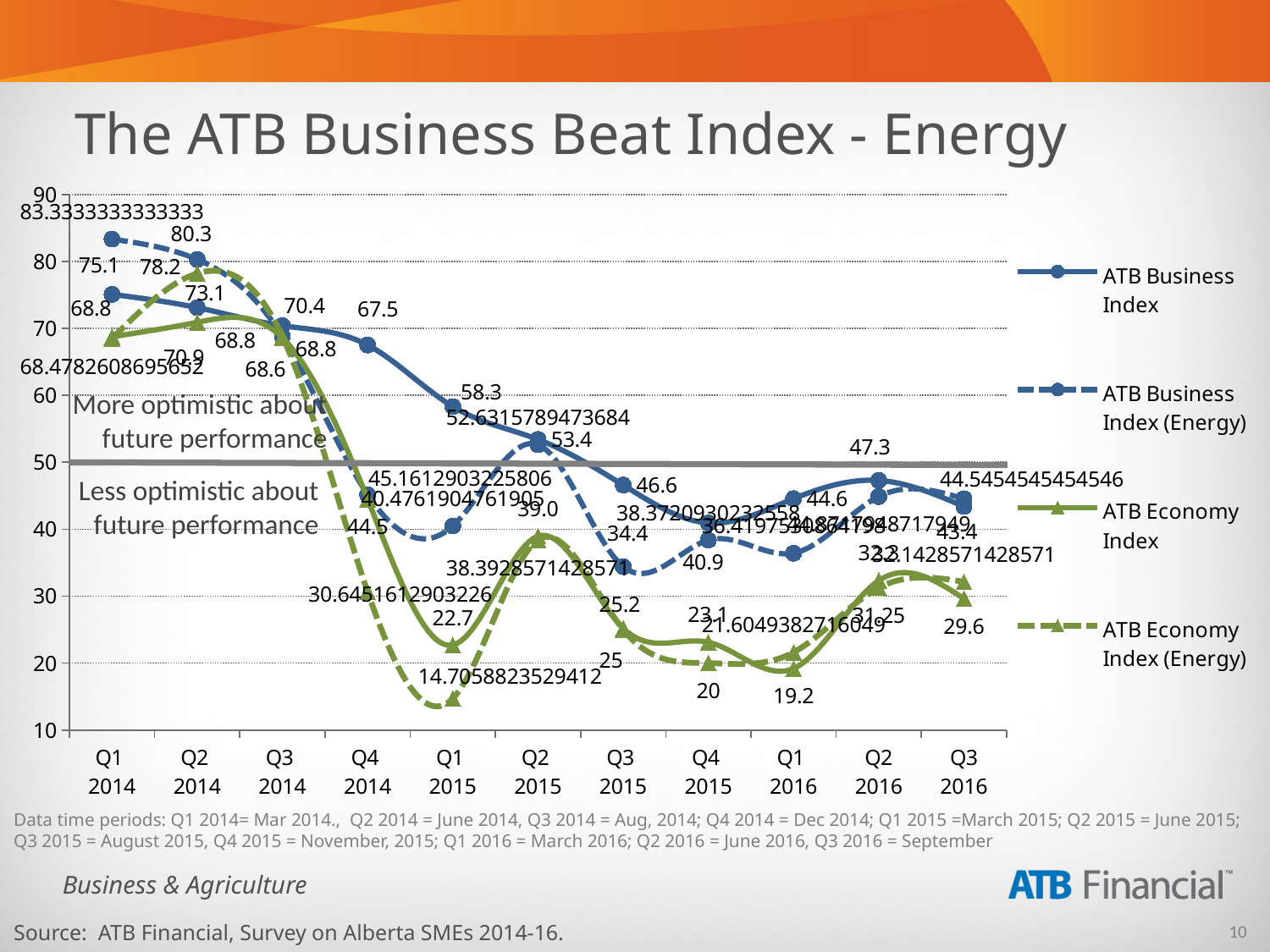
What kind of chart is shown on the slide? line chart In which quarter does the ATB Business Index reach its lowest value? Q4 2015 Is the ATB Business Index higher in Q2 2014 or in Q3 2014? Q2 2014 What is the difference between the ATB Business Index in Q1 2014 and in Q3 2016? 31.7 What is the value of the ATB Economy Index (Energy) in Q1 2015? 14.7058823529412 Overall, do the index values rise or fall from Q1 2014 to Q3 2016? fall What is the value of the ATB Business Index in Q1 2014? 75.1 What is the value of the ATB Business Index in Q2 2016? 47.3 What is the value of the ATB Business Index in Q4 2014? 67.5 How many quarters are plotted along the x axis? 11 In which quarter does the ATB Business Index reach its highest value? Q1 2014 How many series does the legend list? 4